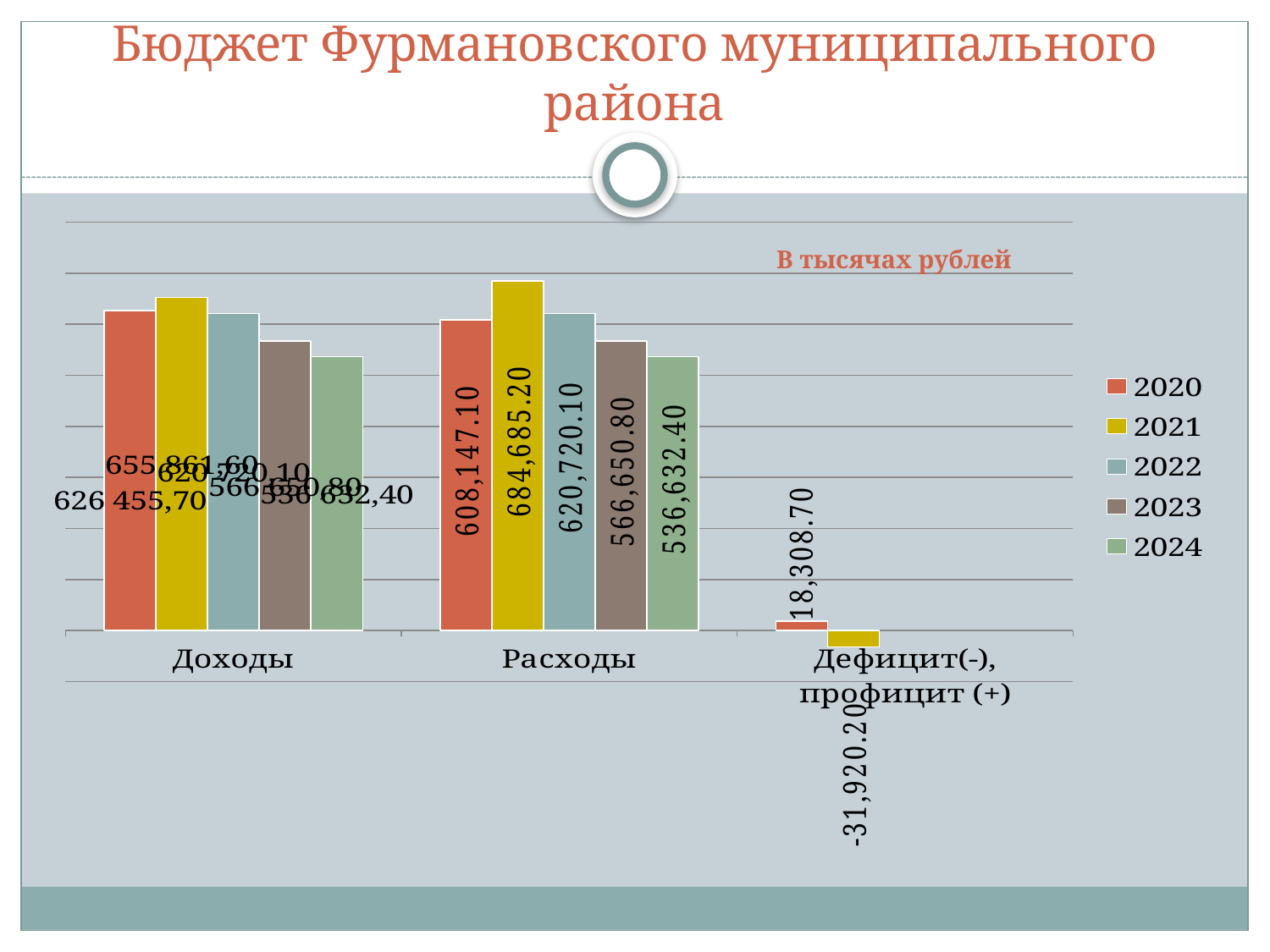
What is the value for Дефицит(-), профицит (+) in 2021? -31,920.20 What is the value for Расходы in 2024? 536,632.40 What is the value for Расходы in 2021? 684,685.20 How many series does the legend list? 5 How many categories are shown on the x axis? 3 What kind of chart is shown on the slide? bar chart What is the value for Дефицит(-), профицит (+) in 2020? 18,308.70 Which year has the lowest value for Расходы? 2024 In what units are the values shown, according to the note on the chart? В тысячах рублей What is the difference between the Расходы values for 2021 and 2020? 76,538.10 Which year has the highest value for Расходы? 2021 For Доходы, which is larger: the 2021 bar or the 2024 bar? 2021